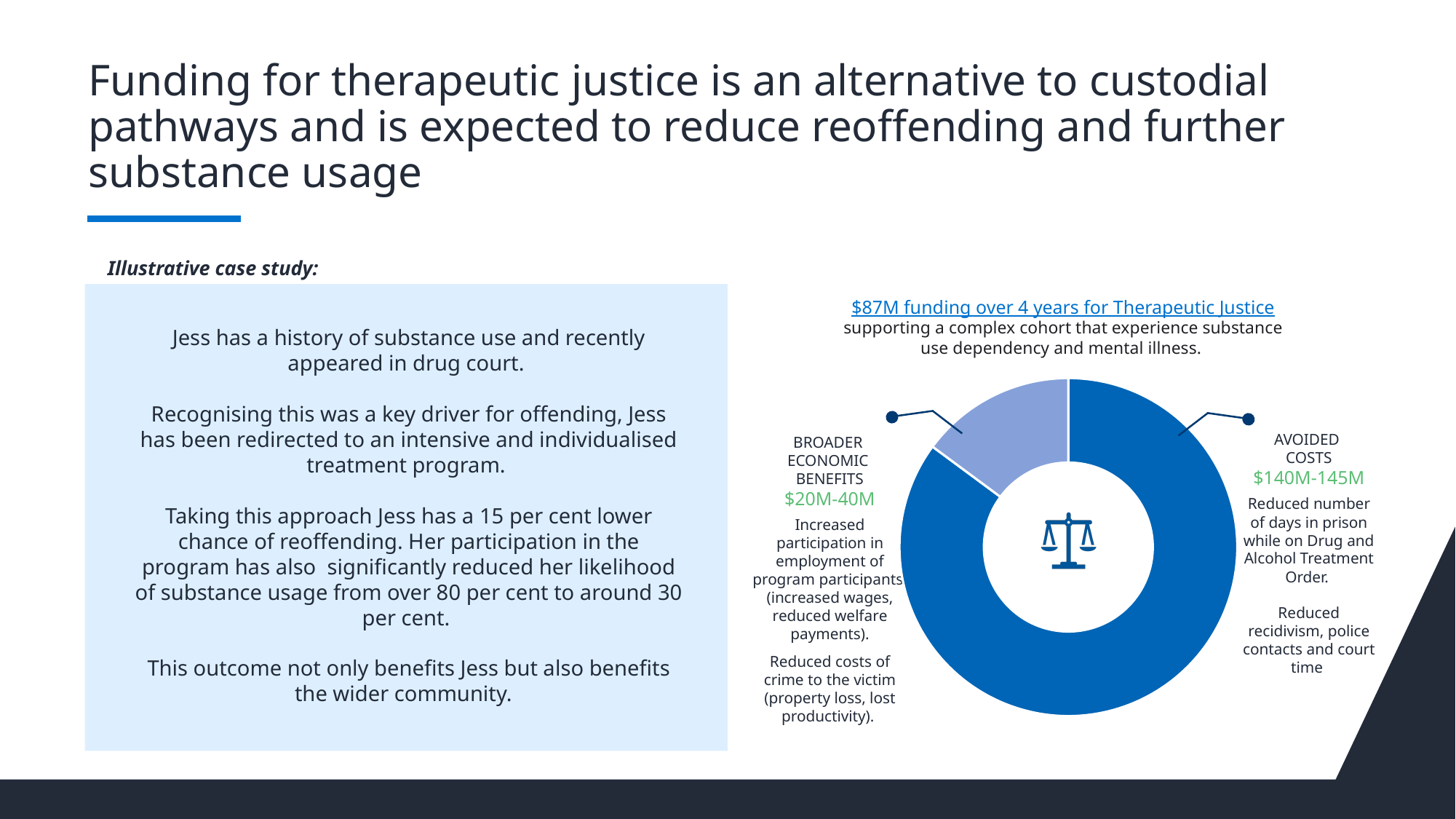
What value is shown for Broader Economic Benefits on the donut chart? $20M-40M Does the Avoided Costs segment take up more or less than half of the donut chart? More What value is shown for Avoided Costs on the donut chart? $140M-145M What total funding amount over 4 years is stated above the donut chart? $87M Which is larger on the donut chart: Avoided Costs or Broader Economic Benefits? Avoided Costs How many segments does the donut chart have? 2 Which segment of the donut chart is coloured light purple-blue? Broader Economic Benefits What kind of chart is shown on the right of the slide? Donut (pie) chart Which segment of the donut chart is the smallest? Broader Economic Benefits Which segment of the donut chart is the largest? Avoided Costs